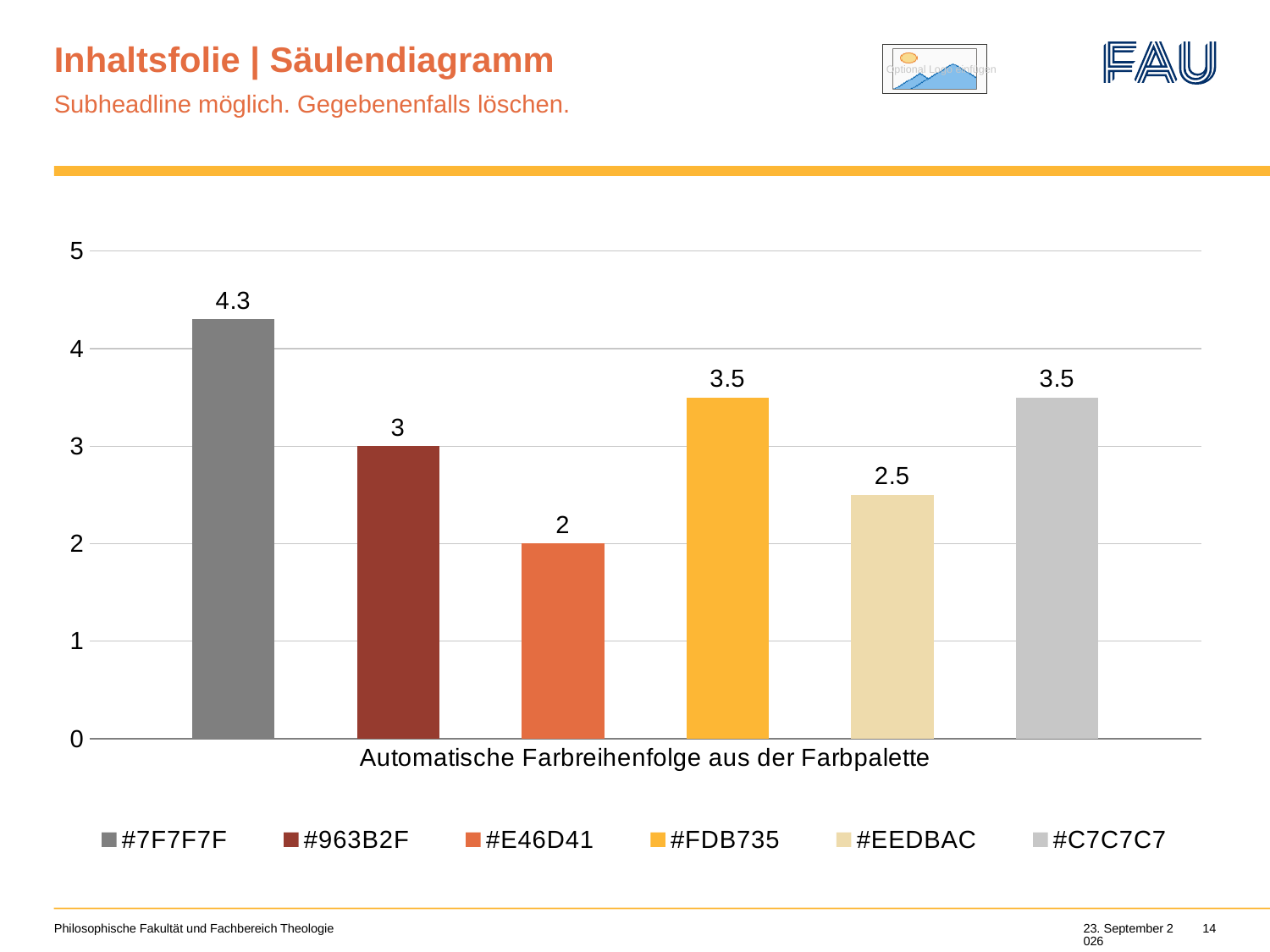
What is the value for the series #E46D41? 2 How many series does the legend list? 6 Which series has the lowest value? #E46D41 What is the category label shown on the x axis? Automatische Farbreihenfolge aus der Farbpalette What is the value for the series #963B2F? 3 Which series has the highest value? #7F7F7F What kind of chart is shown on the slide? Bar chart Which is larger, the value for #963B2F or the value for #C7C7C7? #C7C7C7 What is the difference between the values for #7F7F7F and #963B2F? 1.3 What is the value for the series #EEDBAC? 2.5 What is the difference between the values for #FDB735 and #EEDBAC? 1 What is the value for the series #7F7F7F? 4.3